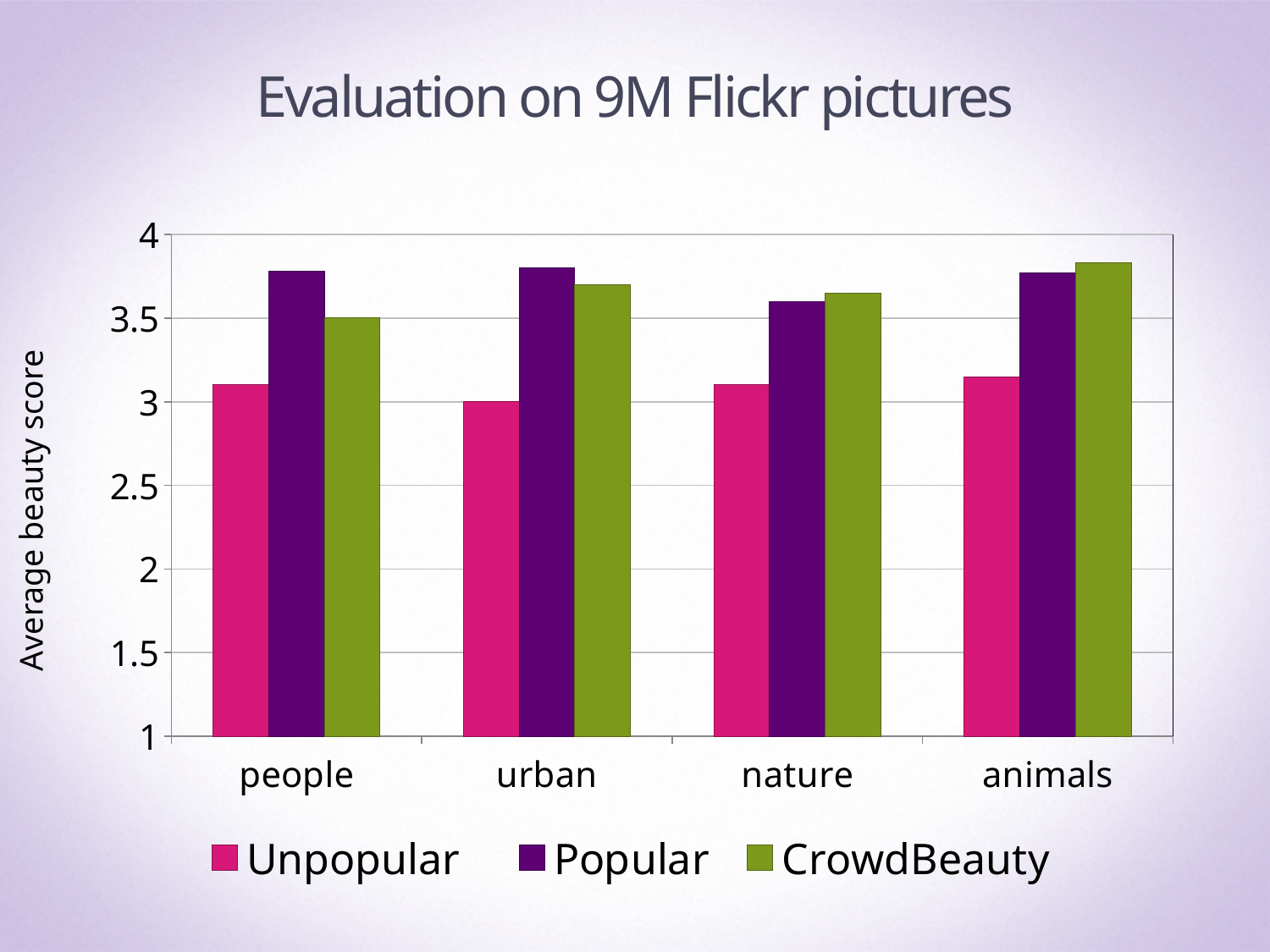
For the people category, which is larger: the Popular value or the CrowdBeauty value? Popular What is the label on the vertical axis? Average beauty score What kind of chart is shown on the slide? bar chart Is the Unpopular value for animals greater or less than 3.5? less Which category has the lowest CrowdBeauty value? people Is the Unpopular value for people greater or less than 3? greater Is the CrowdBeauty value for animals greater or less than 3.5? greater Which category has the highest CrowdBeauty value? animals How many categories are shown on the x axis? 4 How many series does the legend list? 3 What is the title of the chart? Evaluation on 9M Flickr pictures